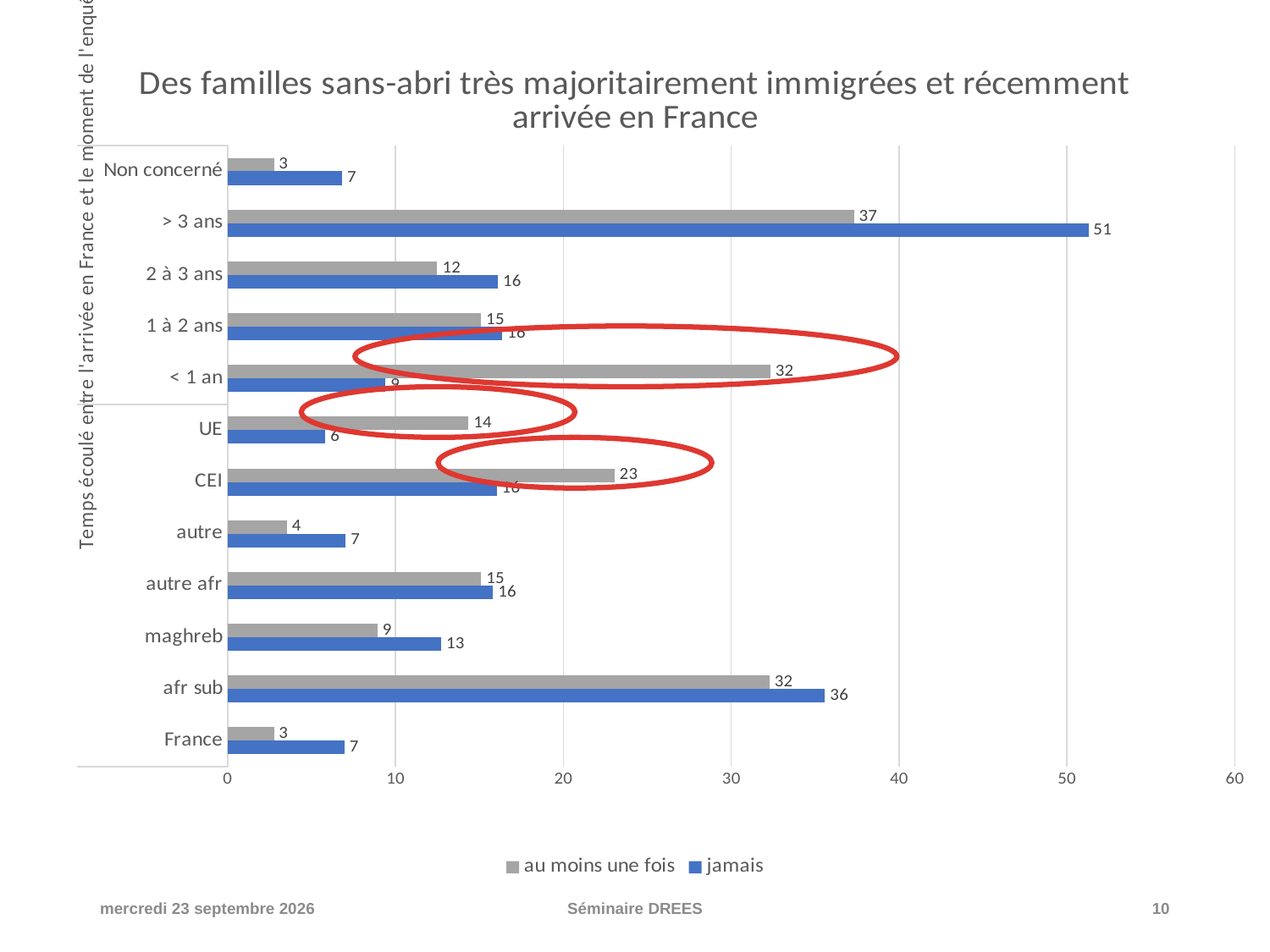
What is the difference between the 'jamais' and 'au moins une fois' values for '> 3 ans'? 14 What type of chart is shown on the slide? bar chart How many series does the legend list? 2 How many categories are shown on the vertical axis of the chart? 12 What is the value of 'jamais' for '> 3 ans'? 51 Which category has the lowest value for the 'jamais' series? UE What is the value of 'au moins une fois' for 'UE'? 14 Which series is shown in blue in the legend? jamais What is the value of 'jamais' for 'maghreb'? 13 What is the value of 'au moins une fois' for 'afr sub'? 32 For 'UE', which series has the larger value, 'au moins une fois' or 'jamais'? au moins une fois Which category has the highest value for the 'jamais' series? > 3 ans